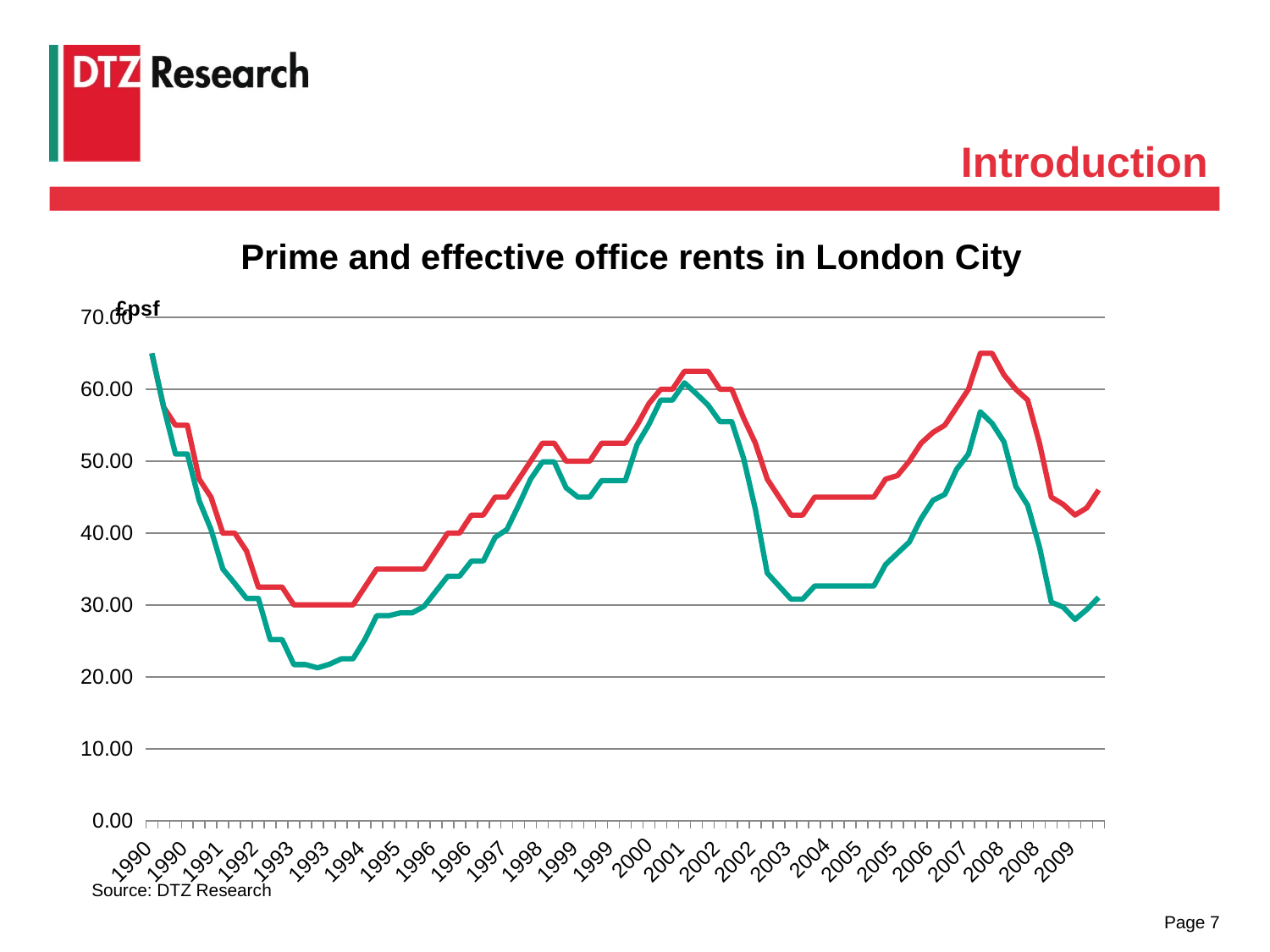
Is the value of the green line in 2003 greater or less than 40.00? less What is the title of the chart? Prime and effective office rents in London City Do the values of both lines rise or fall between 2003 and 2007? Rise In which year does the green line reach its lowest point? 1993 What kind of chart is shown on the slide? Line chart Is the value of the red line in 2003 greater or less than 50.00? less How many lines are plotted on the chart? 2 Is the value of the green line in 1993 greater or less than 30.00? less Which line is higher in 2008, the red line or the green line? The red line What unit label is shown on the y axis of the chart? £psf Do the values of both lines rise or fall between 1990 and 1993? Fall